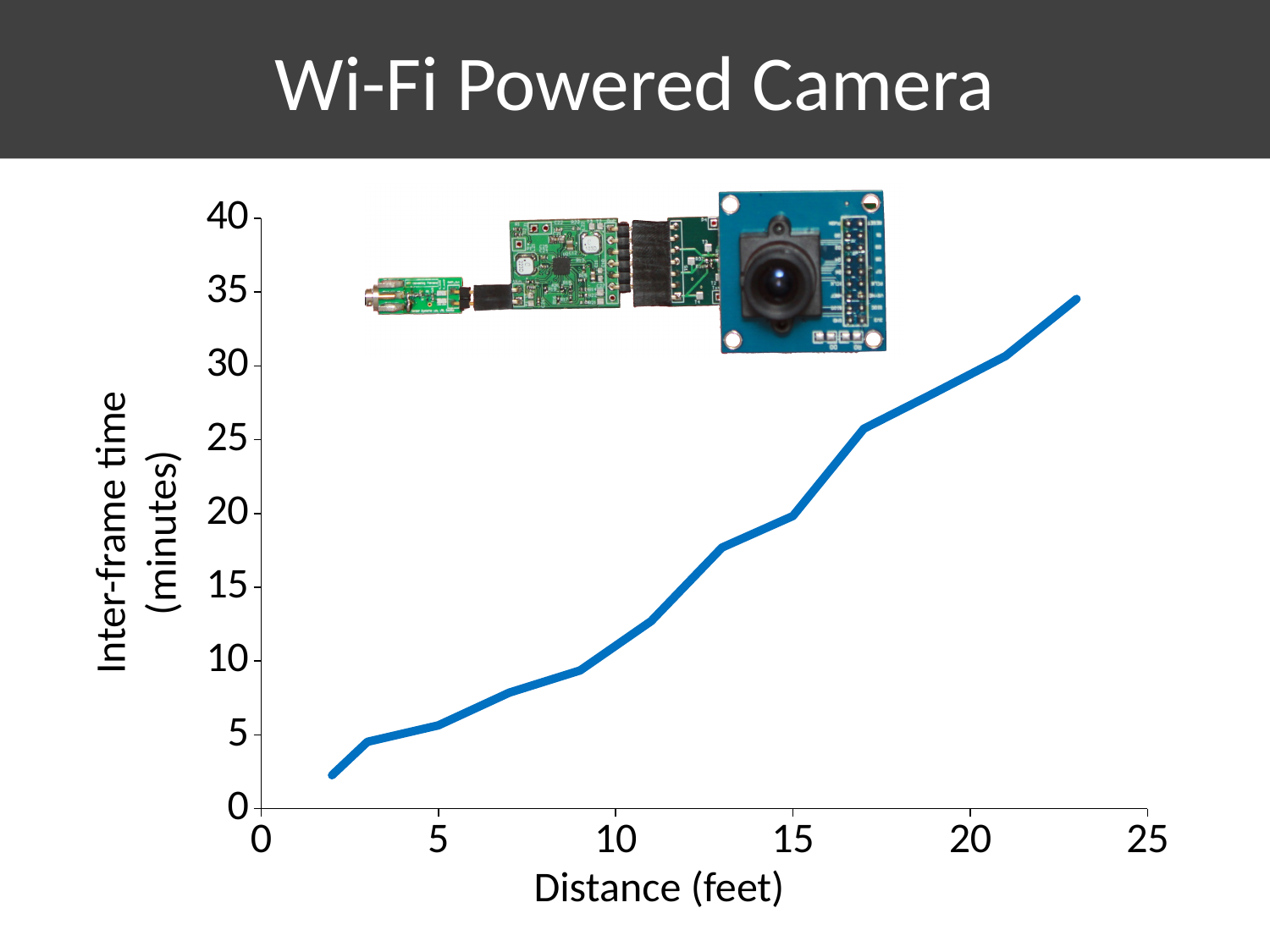
Is the inter-frame time at 11 feet greater or less than 15 minutes? less Does the inter-frame time rise or fall as distance increases? rise Is the inter-frame time at 7 feet greater or less than 10 minutes? less What kind of chart is shown on the slide? line chart Is the inter-frame time at 13 feet greater or less than 15 minutes? greater What is the label of the x axis? Distance (feet) What is the label of the y axis? Inter-frame time (minutes)